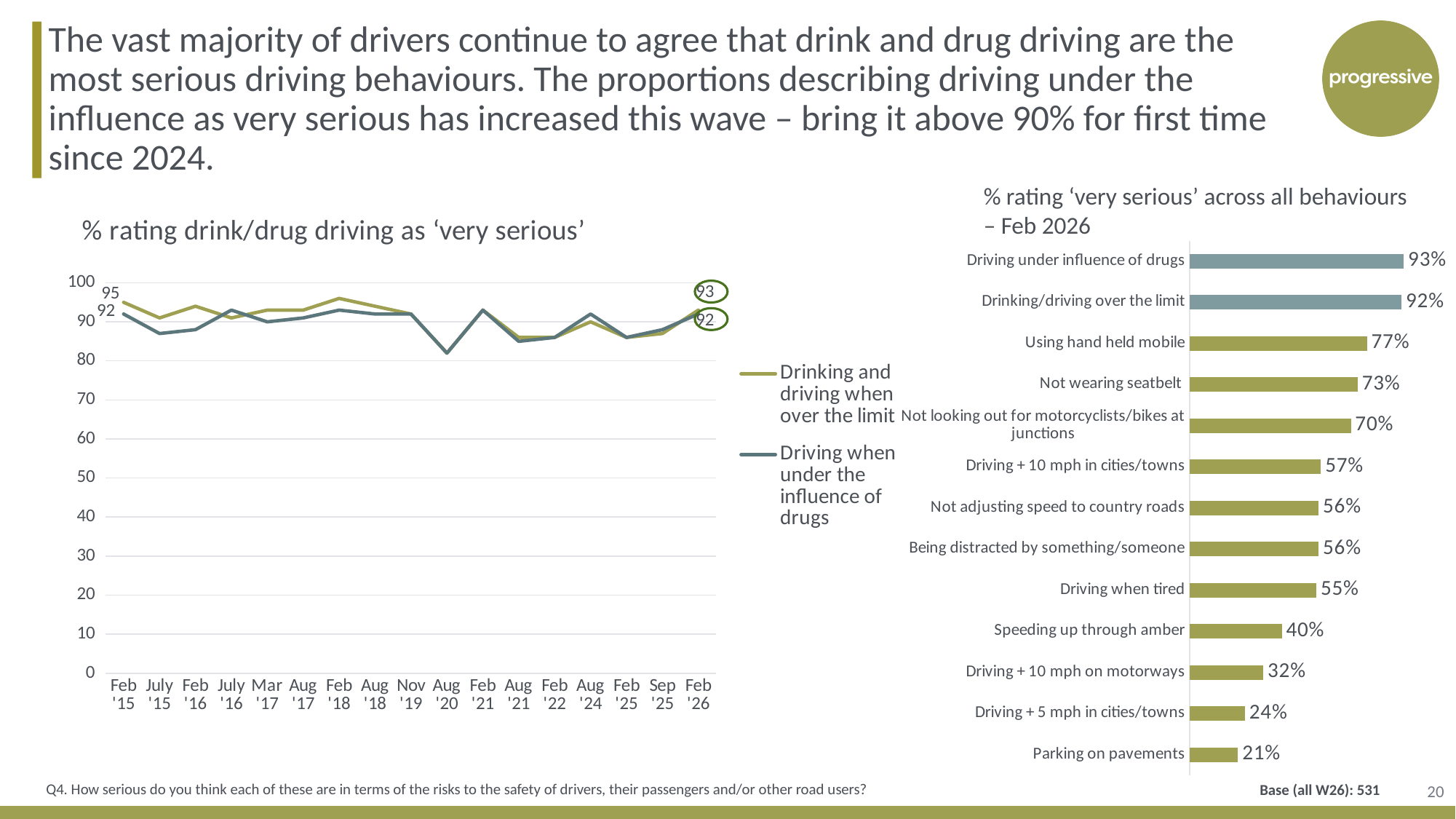
In the line chart on the left, what was the value for 'Driving when under the influence of drugs' in Feb '26? 92 In the line chart on the left, what was the value for 'Drinking and driving when over the limit' in Feb '15? 95 What type of chart is the '% rating very serious across all behaviours – Feb 2026' chart? Bar chart In the line chart on the left, is the value for 'Driving when under the influence of drugs' in Aug '20 greater or less than 90? less In the bar chart on the right, which behaviour has the highest percentage rating it 'very serious'? Driving under influence of drugs What type of chart is the '% rating drink/drug driving as very serious' chart? Line chart How many series does the legend of the '% rating drink/drug driving as very serious' chart list? 2 In the bar chart on the right, which behaviour has the lowest percentage rating it 'very serious'? Parking on pavements In the bar chart on the right, what is the difference in percentage points between 'Not wearing seatbelt' and 'Speeding up through amber'? 33 percentage points In the bar chart on the right, what percentage rated 'Using hand held mobile' as very serious? 77% How many behaviours are listed in the bar chart on the right? 13 In the bar chart on the right, which is larger: 'Driving when tired' or 'Driving + 10 mph on motorways'? Driving when tired